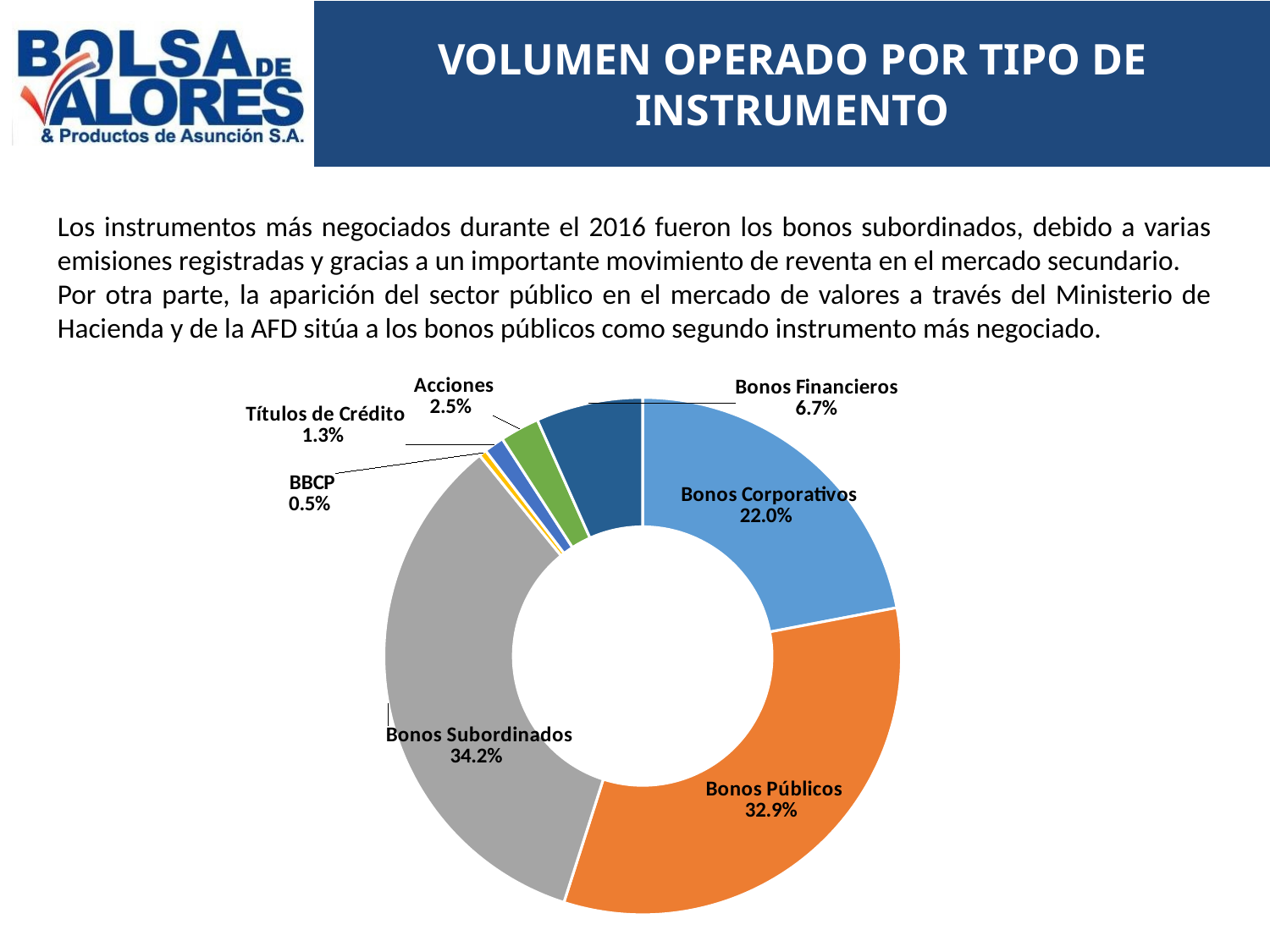
What is the value shown for BBCP? 0.5% Which instrument type has the largest share? Bonos Subordinados What share of the volume is Bonos Subordinados? 34.2% Which instrument type has the smallest share? BBCP What share of the volume is Bonos Públicos? 32.9% What is the difference between the shares of Bonos Subordinados and Bonos Públicos? 1.3% What is the value shown for Bonos Corporativos? 22.0% What is the value shown for Acciones? 2.5% What kind of chart is shown on the slide? Pie chart (doughnut) What is the value shown for Bonos Financieros? 6.7% How many instrument types are shown in the chart? 7 Which is larger, the share for Bonos Corporativos or Bonos Financieros? Bonos Corporativos